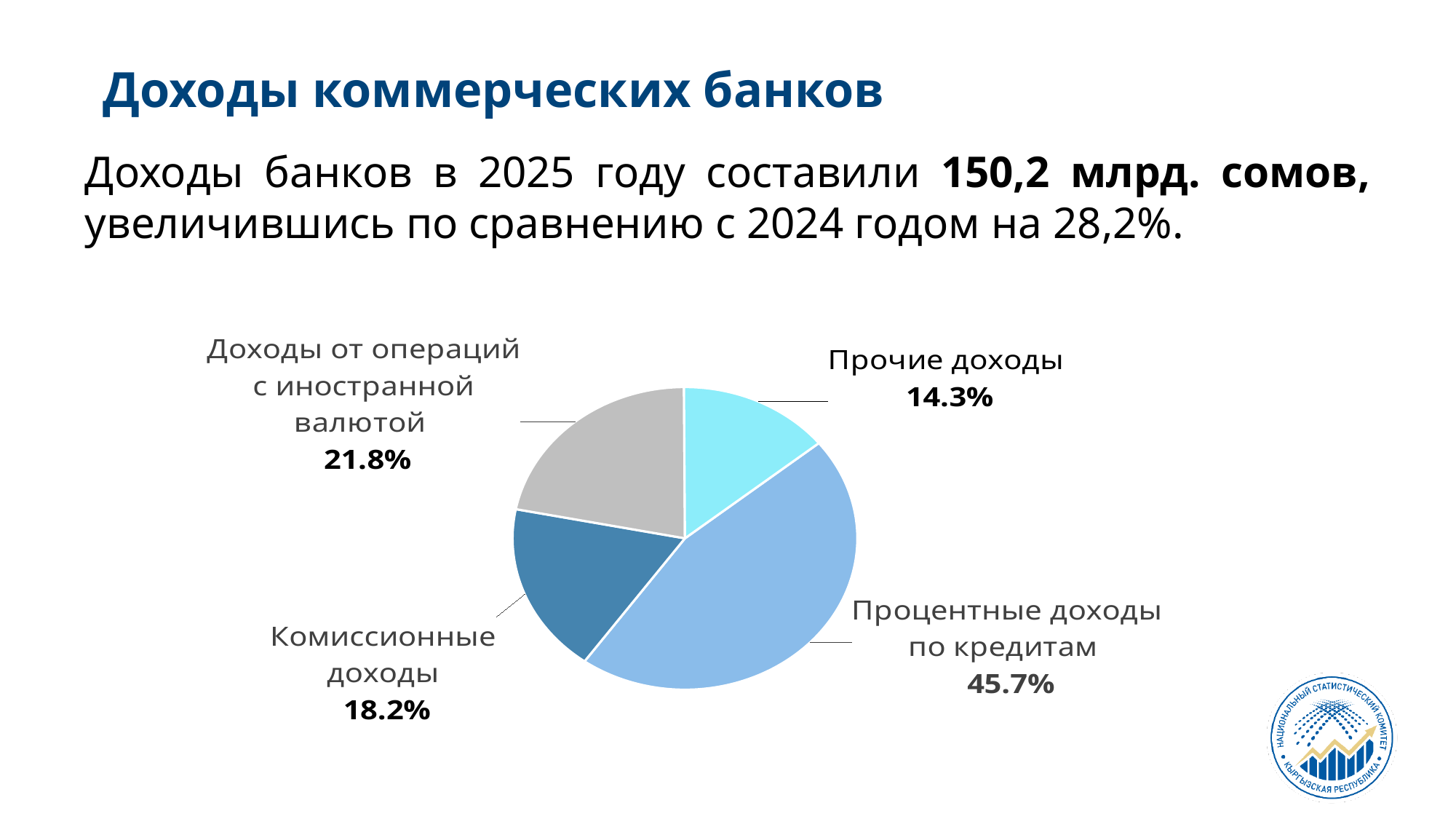
What kind of chart is shown on the slide? Pie chart What is the title of the slide containing the chart? Доходы коммерческих банков How many slices does the pie chart have? 4 What share of the pie does "Процентные доходы по кредитам" have? 45.7% What is the difference in percentage points between "Процентные доходы по кредитам" and "Доходы от операций с иностранной валютой"? 23.9 Which category has the largest slice of the pie? Процентные доходы по кредитам What share of the pie does "Прочие доходы" have? 14.3% What is the difference in percentage points between "Доходы от операций с иностранной валютой" and "Комиссионные доходы"? 3.6 Which is larger: the share for "Комиссионные доходы" or the share for "Прочие доходы"? Комиссионные доходы What share of the pie does "Доходы от операций с иностранной валютой" have? 21.8% Which category has the smallest slice of the pie? Прочие доходы What share of the pie does "Комиссионные доходы" have? 18.2%